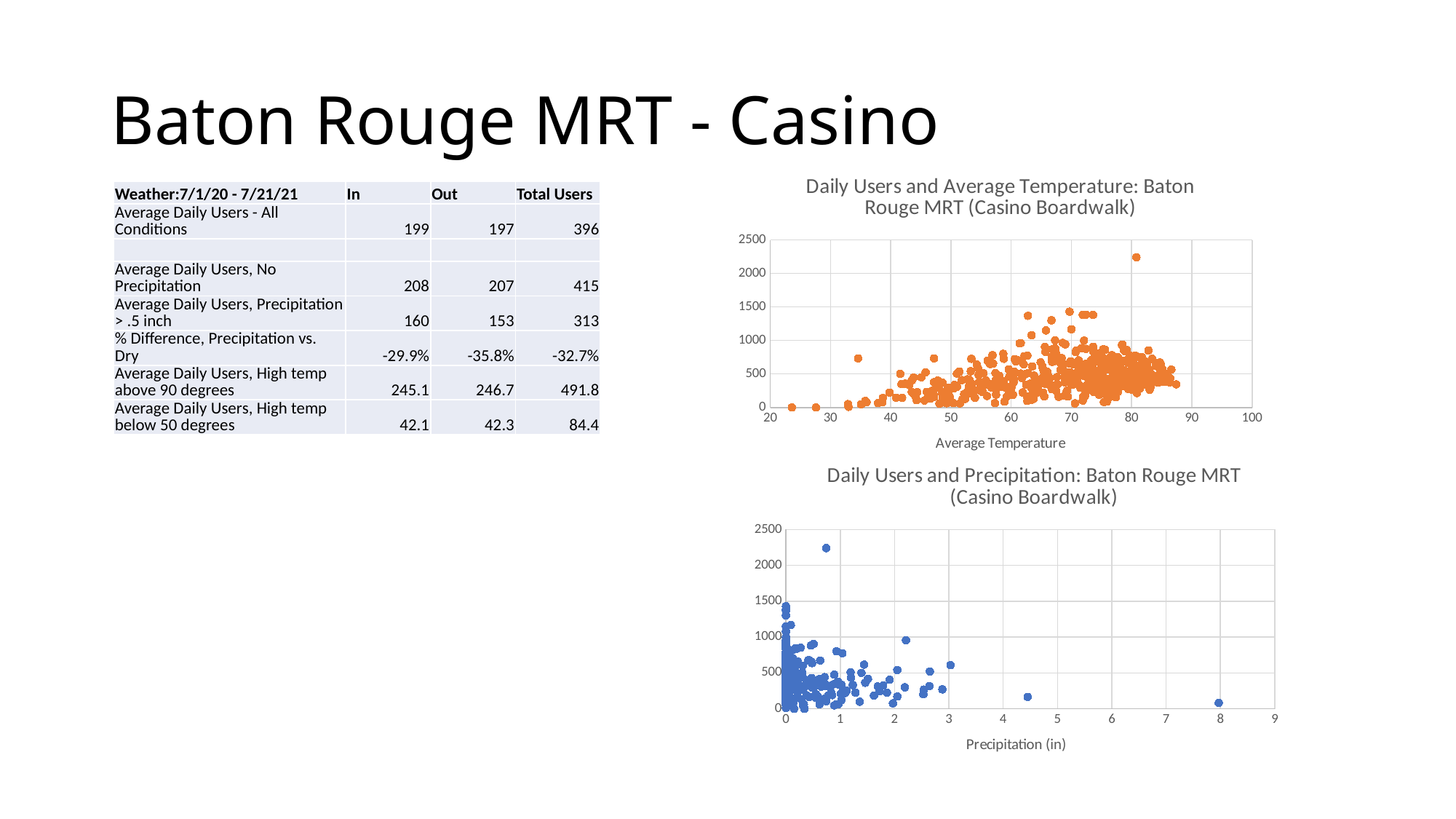
In the bottom chart, is the highest plotted point greater or less than 2000 daily users? greater In the top chart, what is the label of the x axis? Average Temperature In the bottom chart, do daily users generally rise or fall as precipitation increases along the x axis? fall What kind of chart is the top chart, 'Daily Users and Average Temperature: Baton Rouge MRT (Casino Boardwalk)'? Scatter chart What kind of chart is the bottom chart, 'Daily Users and Precipitation: Baton Rouge MRT (Casino Boardwalk)'? Scatter chart In the top chart, is the value for the leftmost point (near 23 degrees) greater or less than 500? less In the bottom chart, is the value for the point near 4.5 inches of precipitation greater or less than 500? less In the top chart, do daily users generally rise or fall as average temperature increases from 30 to 70 degrees? rise In the bottom chart, what is the label of the x axis? Precipitation (in) In the top chart, what is the highest value shown on the y axis? 2500